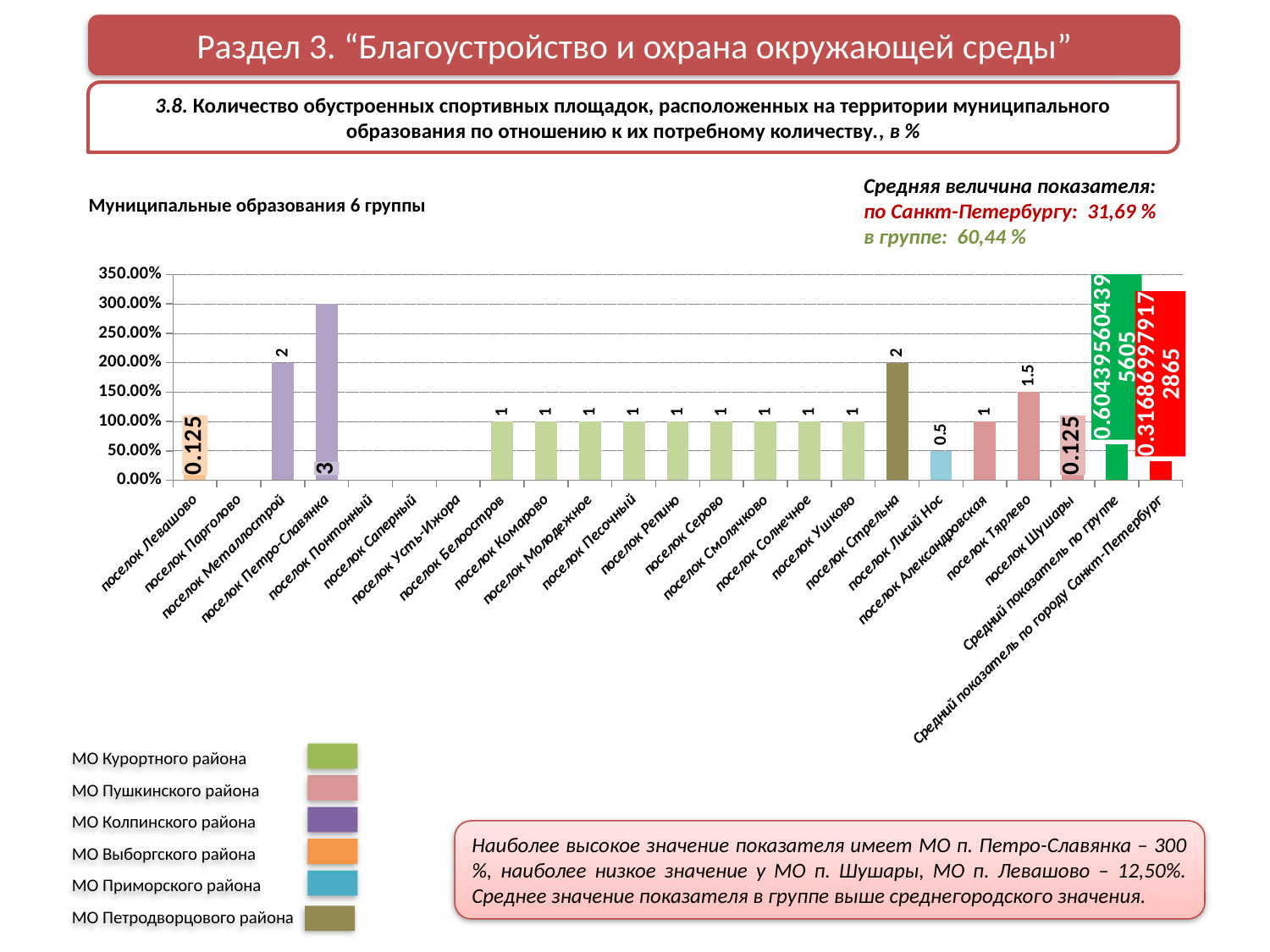
What is the difference between the values for поселок Металлострой and поселок Лисий Нос? 1.5 What kind of chart is shown on the slide? bar chart What is the value shown for поселок Тярлево? 1.5 What is the value shown for поселок Петро-Славянка? 3 Which category has the highest bar in the chart? поселок Петро-Славянка Which has the larger value: поселок Стрельна or поселок Тярлево? поселок Стрельна What colour is used in the legend for МО Курортного района? green What is the value shown for поселок Левашово? 0.125 Is the value for поселок Лисий Нос greater or less than 100.00%? less What is the value shown for поселок Лисий Нос? 0.5 How many categories are listed along the x axis of the chart? 23 Is the value for поселок Петро-Славянка greater or less than 250.00%? greater